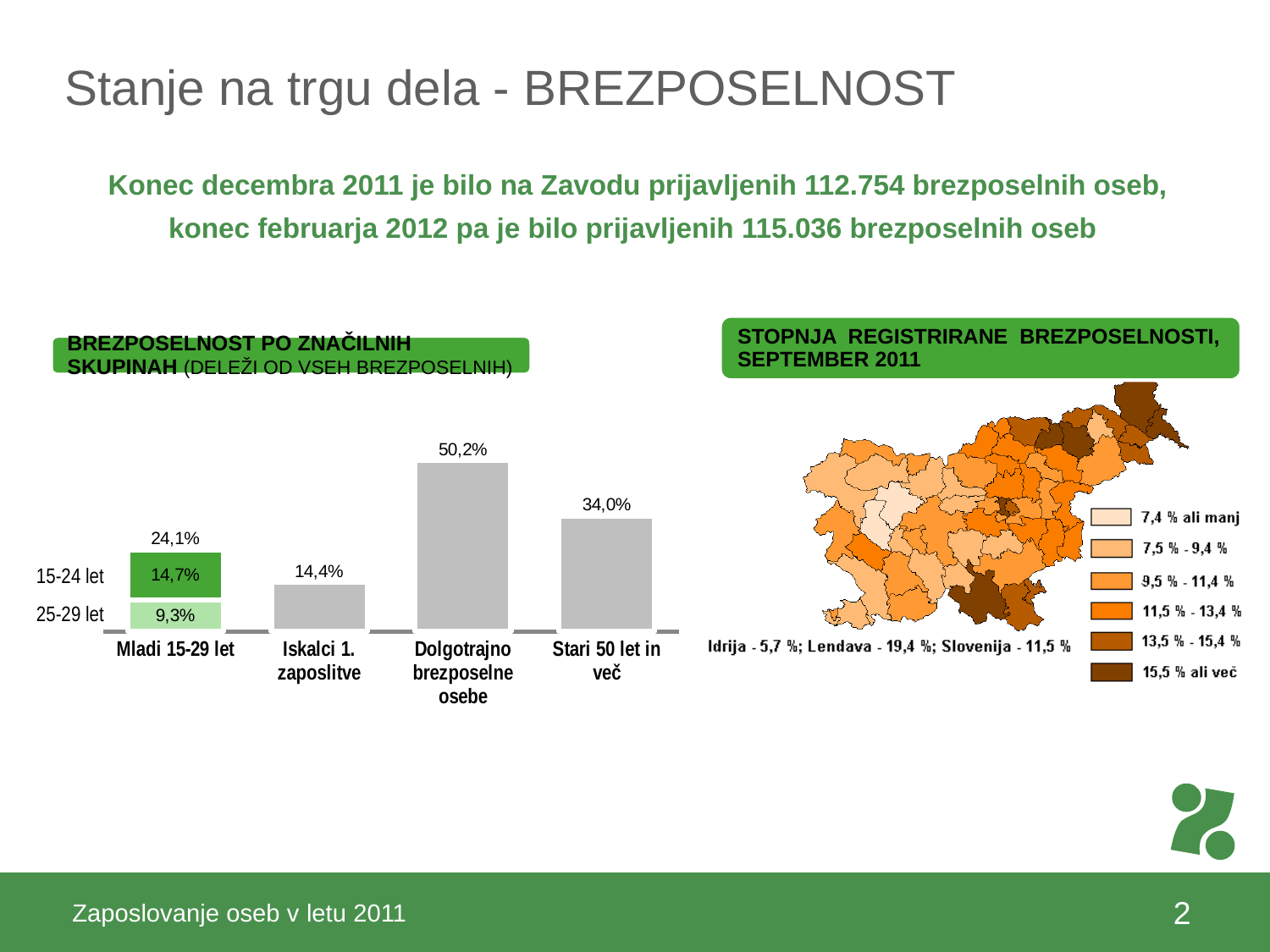
In the bar chart 'Brezposelnost po značilnih skupinah', what share is shown for the 15-24 let segment of the Mladi 15-29 let bar? 14,7% How many categories are shown on the x axis of the bar chart 'Brezposelnost po značilnih skupinah'? 4 In the bar chart 'Brezposelnost po značilnih skupinah', what is the total of the stacked Mladi 15-29 let bar? 24,1% What kind of chart is 'Brezposelnost po značilnih skupinah'? Bar chart In the bar chart 'Brezposelnost po značilnih skupinah', what share is shown for the 25-29 let segment of the Mladi 15-29 let bar? 9,3% In the bar chart 'Brezposelnost po značilnih skupinah', what is the difference between Dolgotrajno brezposelne osebe and Stari 50 let in več? 16,2 percentage points In the bar chart 'Brezposelnost po značilnih skupinah', which category has the lowest value? Iskalci 1. zaposlitve In the bar chart 'Brezposelnost po značilnih skupinah', what is the value for Dolgotrajno brezposelne osebe? 50,2% In the bar chart 'Brezposelnost po značilnih skupinah', which is larger: Stari 50 let in več or Mladi 15-29 let? Stari 50 let in več In the bar chart 'Brezposelnost po značilnih skupinah', which category has the highest value? Dolgotrajno brezposelne osebe In the bar chart 'Brezposelnost po značilnih skupinah', what is the value for Stari 50 let in več? 34,0% In the bar chart 'Brezposelnost po značilnih skupinah', what is the value for Iskalci 1. zaposlitve? 14,4%